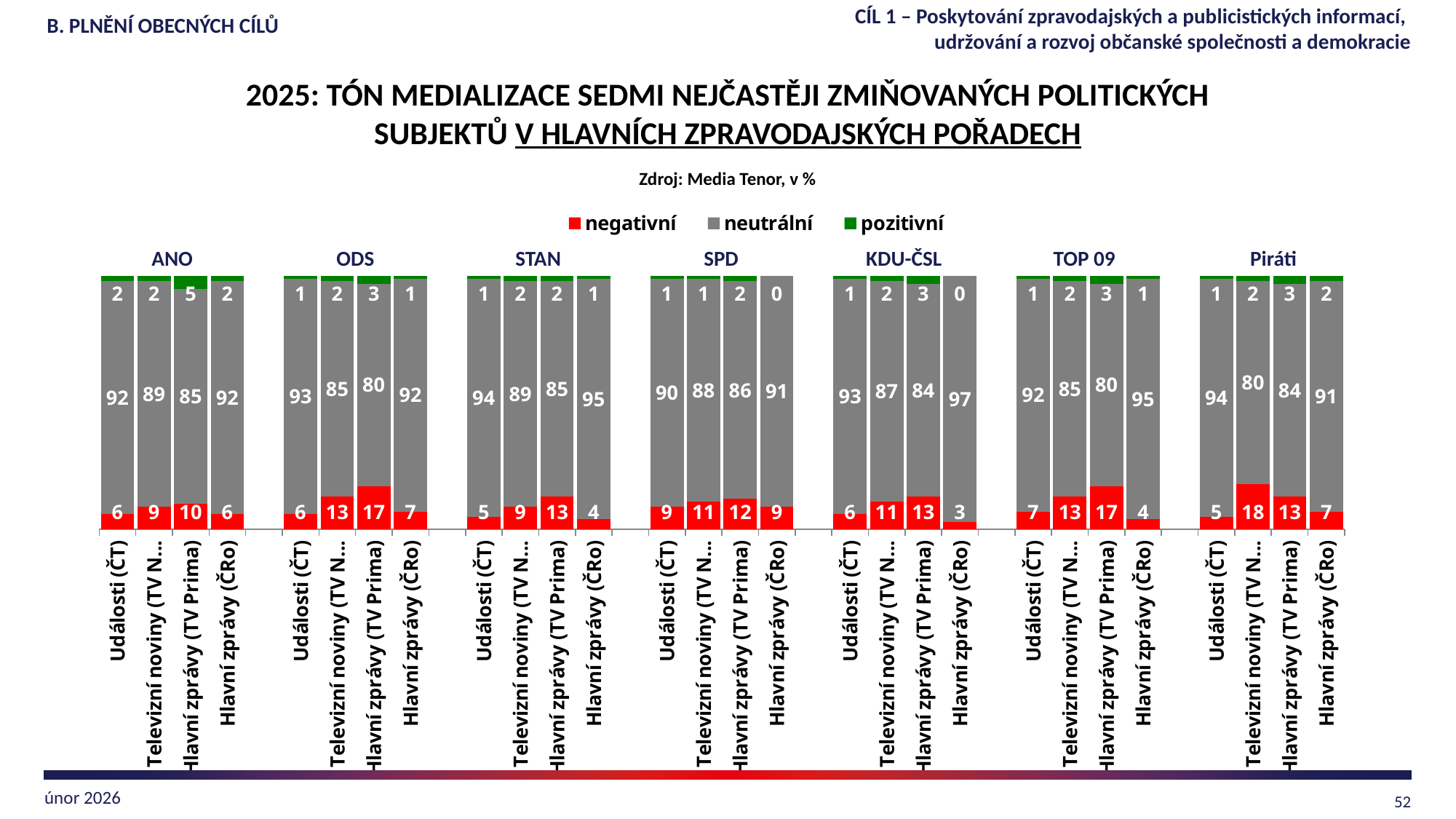
What colour represents the negativní series in the legend? red What kind of chart is shown on the slide? stacked bar chart What is the total of the stacked bar for ANO in Hlavní zprávy (TV Prima)? 100 What is the difference between the negativní value for ODS in Hlavní zprávy (TV Prima) and in Události (ČT)? 11 Which has the larger negativní value in Události (ČT): SPD or STAN? SPD Which bar has the lowest negativní value on the chart? KDU-ČSL, Hlavní zprávy (ČRo) What is the neutrální value for KDU-ČSL in Hlavní zprávy (ČRo)? 97 How many political subjects are shown on the chart? 7 What is the negativní value for Piráti in Televizní noviny (TV Nova)? 18 What is the pozitivní value for ANO in Hlavní zprávy (TV Prima)? 5 Which bar has the highest negativní value on the chart? Piráti, Televizní noviny (TV Nova) How many series does the legend list? 3